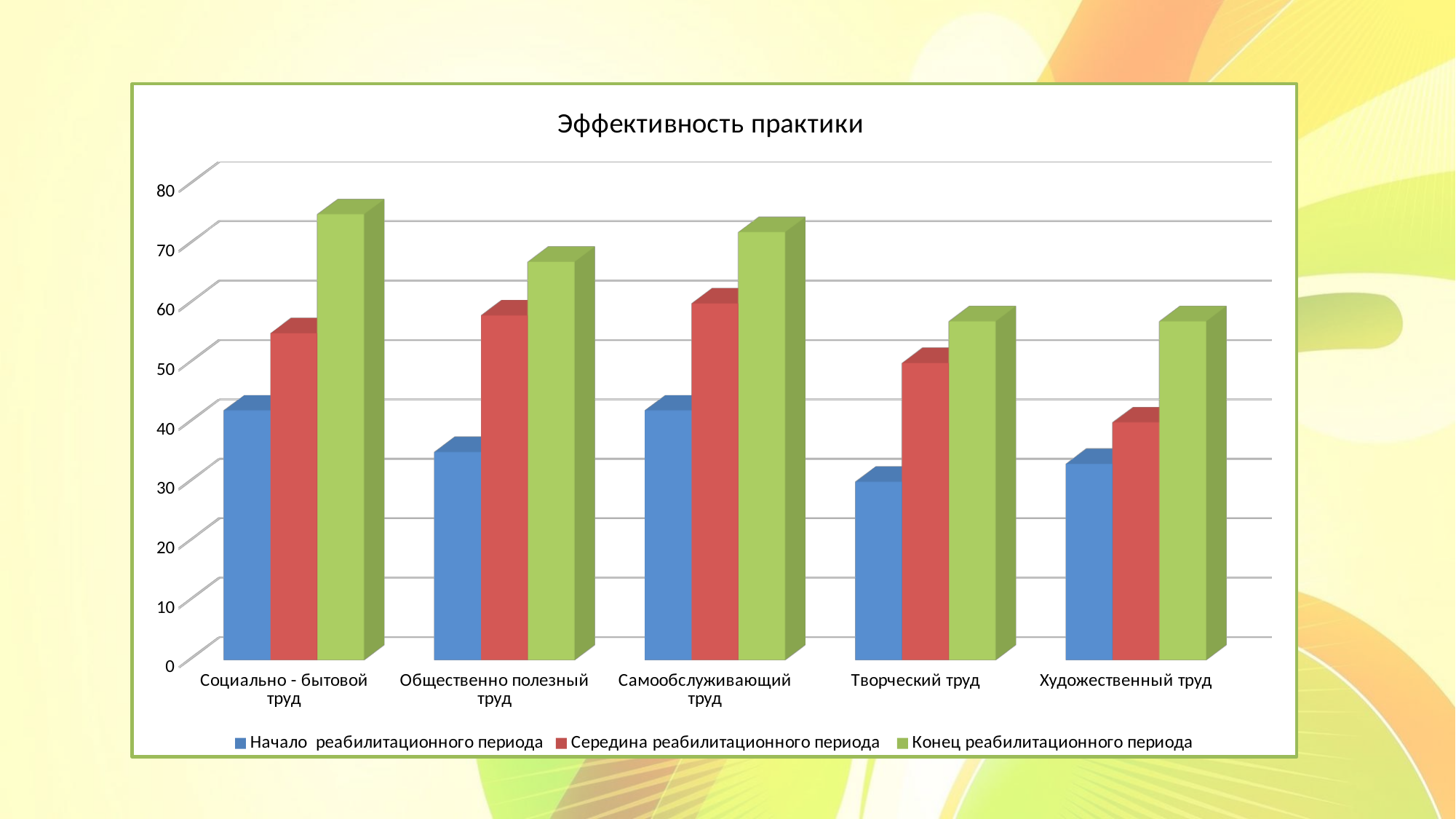
Which category has the highest value for Конец реабилитационного периода? Социально - бытовой труд What kind of chart is shown on the slide? bar chart Which category has the lowest value for Начало реабилитационного периода? Творческий труд What colour represents Конец реабилитационного периода in the legend? green How many series does the legend list? 3 How many categories are shown on the x axis? 5 What is the title of the chart? Эффективность практики Is the Середина реабилитационного периода value for Художественный труд greater or less than 50? less Which is larger: the Середина реабилитационного периода value for Самообслуживающий труд or for Художественный труд? Самообслуживающий труд Is the Начало реабилитационного периода value for Творческий труд greater or less than 40? less Is the Конец реабилитационного периода value for Социально - бытовой труд greater or less than 70? greater Within each category, do the values rise or fall from Начало to Конец реабилитационного периода? rise